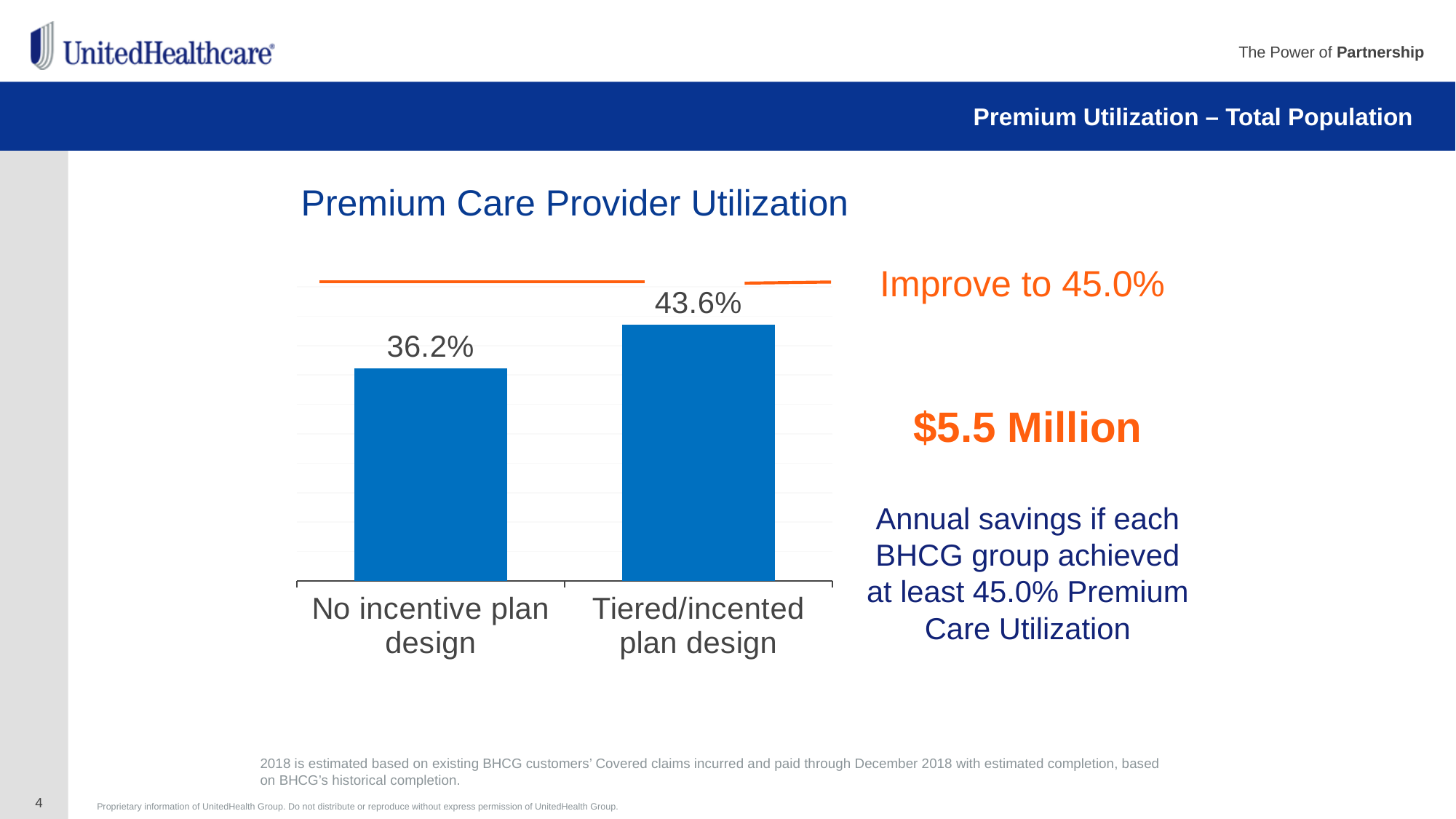
What kind of chart is used to show Premium Care Provider Utilization? bar chart How many categories are shown in the Premium Care Provider Utilization chart? 2 Is the utilization for 'No incentive plan design' larger or smaller than for 'Tiered/incented plan design'? smaller Which category has the higher Premium Care Provider Utilization? Tiered/incented plan design What is the Premium Care Provider Utilization value for the 'Tiered/incented plan design' category? 43.6% Do the bar values rise or fall from left to right across the chart? rise What is the difference in utilization between the 'Tiered/incented plan design' and the 'No incentive plan design' bars? 7.4% Which category has the lower Premium Care Provider Utilization? No incentive plan design What is the title of the chart on the slide? Premium Care Provider Utilization What target utilization level does the orange line on the chart represent? 45.0% What is the Premium Care Provider Utilization value for the 'No incentive plan design' category? 36.2%